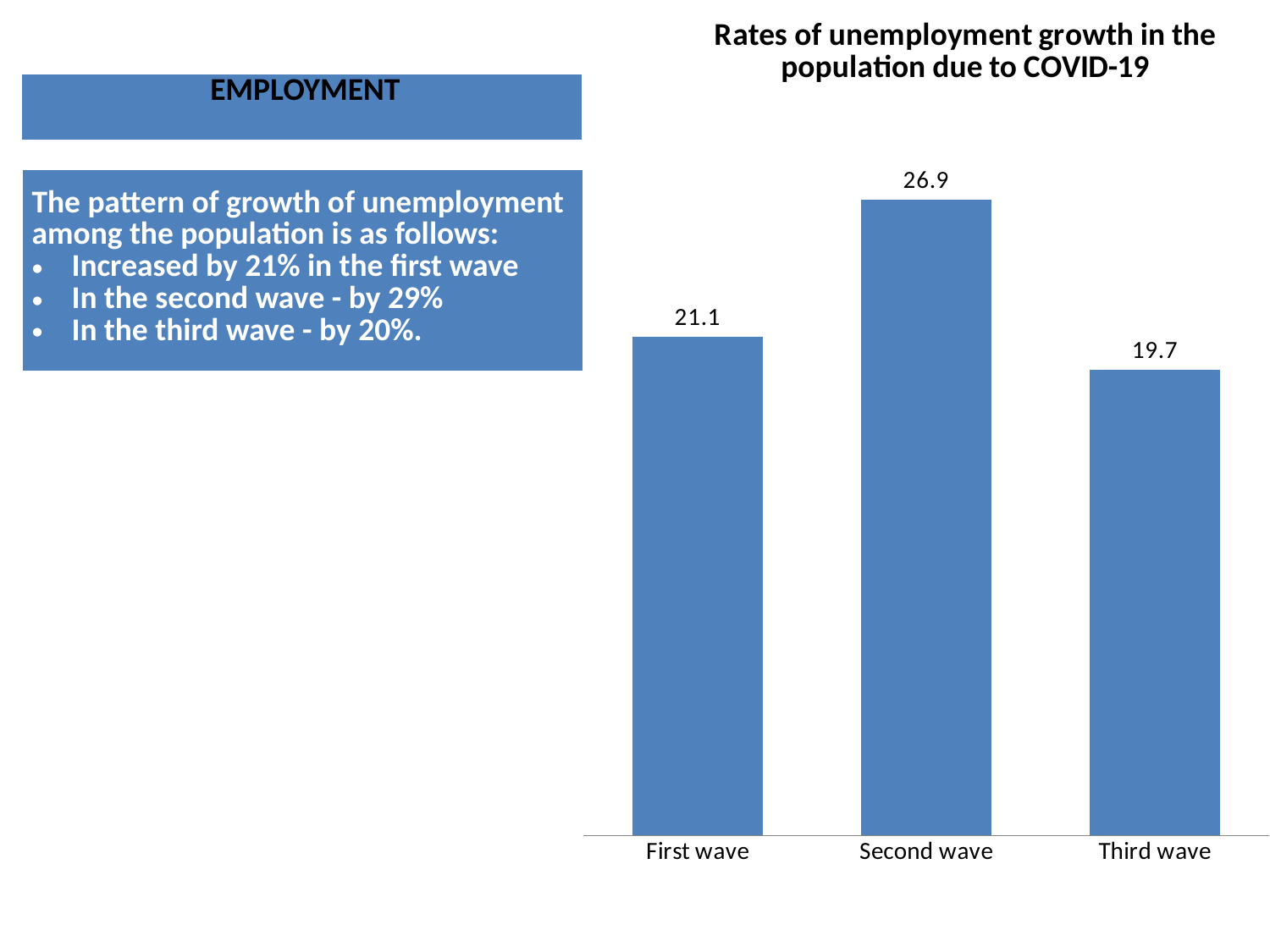
What is the value for Second wave? 26.9 What is the value for Third wave? 19.7 Which is larger, the value for First wave or Third wave? First wave What is the value for First wave? 21.1 Which wave has the lowest value? Third wave Which wave has the highest value? Second wave What colour are the bars in the chart? Blue What is the difference between the Second wave and First wave values? 5.8 What is the difference between the First wave and Third wave values? 1.4 How many categories are shown in the chart? 3 What kind of chart is shown? Bar chart What is the title of the chart? Rates of unemployment growth in the population due to COVID-19